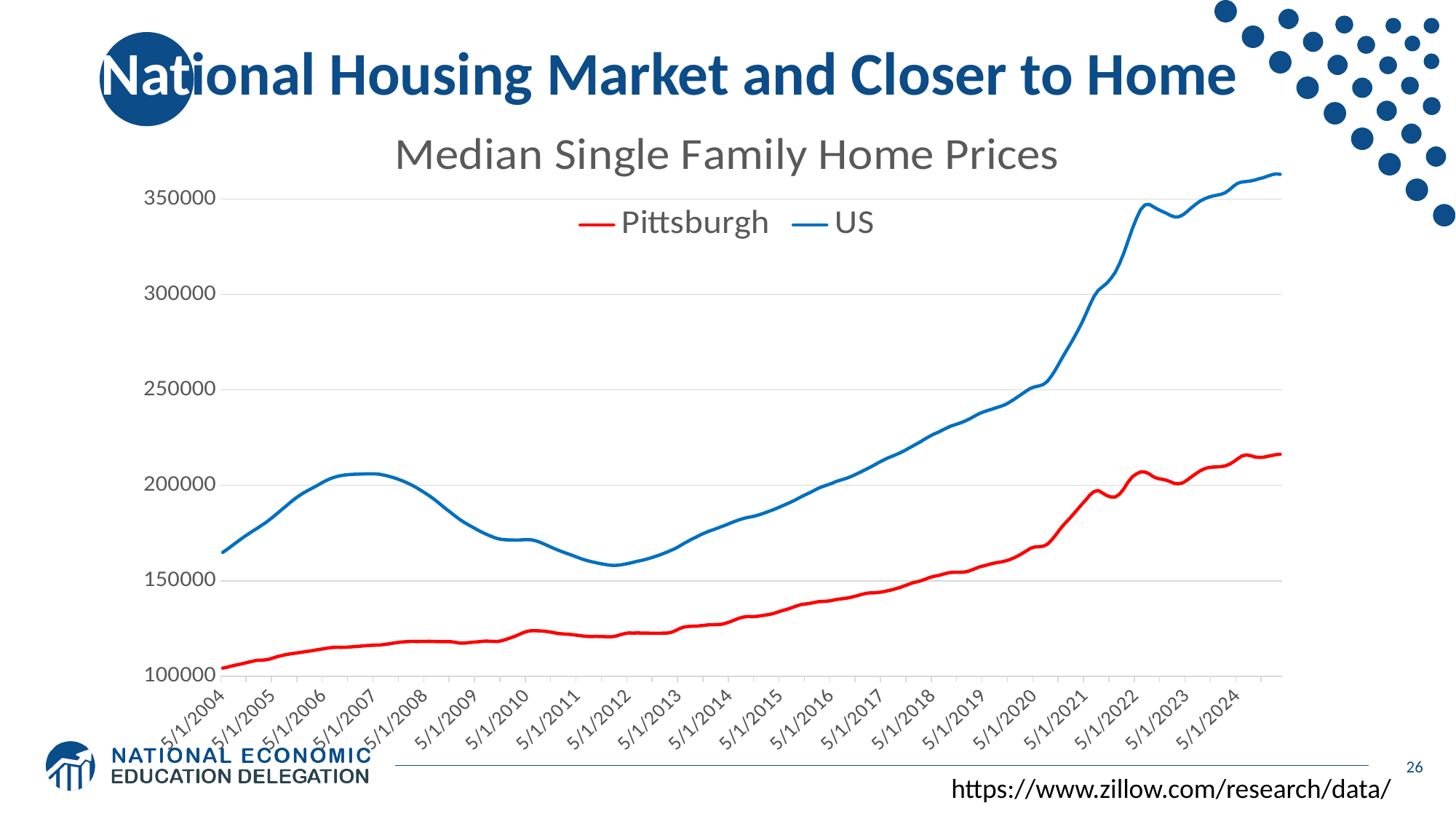
What kind of chart is shown on the slide? line chart Is the Pittsburgh value at 5/1/2024 greater or less than 200000? greater How many date labels are shown on the x axis? 21 What is the title of the chart? Median Single Family Home Prices Is the US value at 5/1/2019 greater or less than 250000? less Is the Pittsburgh value at 5/1/2016 greater or less than 150000? less Which colour is used for the Pittsburgh line? red Does the Pittsburgh line rise or fall overall from 5/1/2004 to 5/1/2024? rise Does the US line rise or fall between 5/1/2007 and 5/1/2012? fall Which series has the higher value at 5/1/2024, Pittsburgh or US? US How many series does the legend list? 2